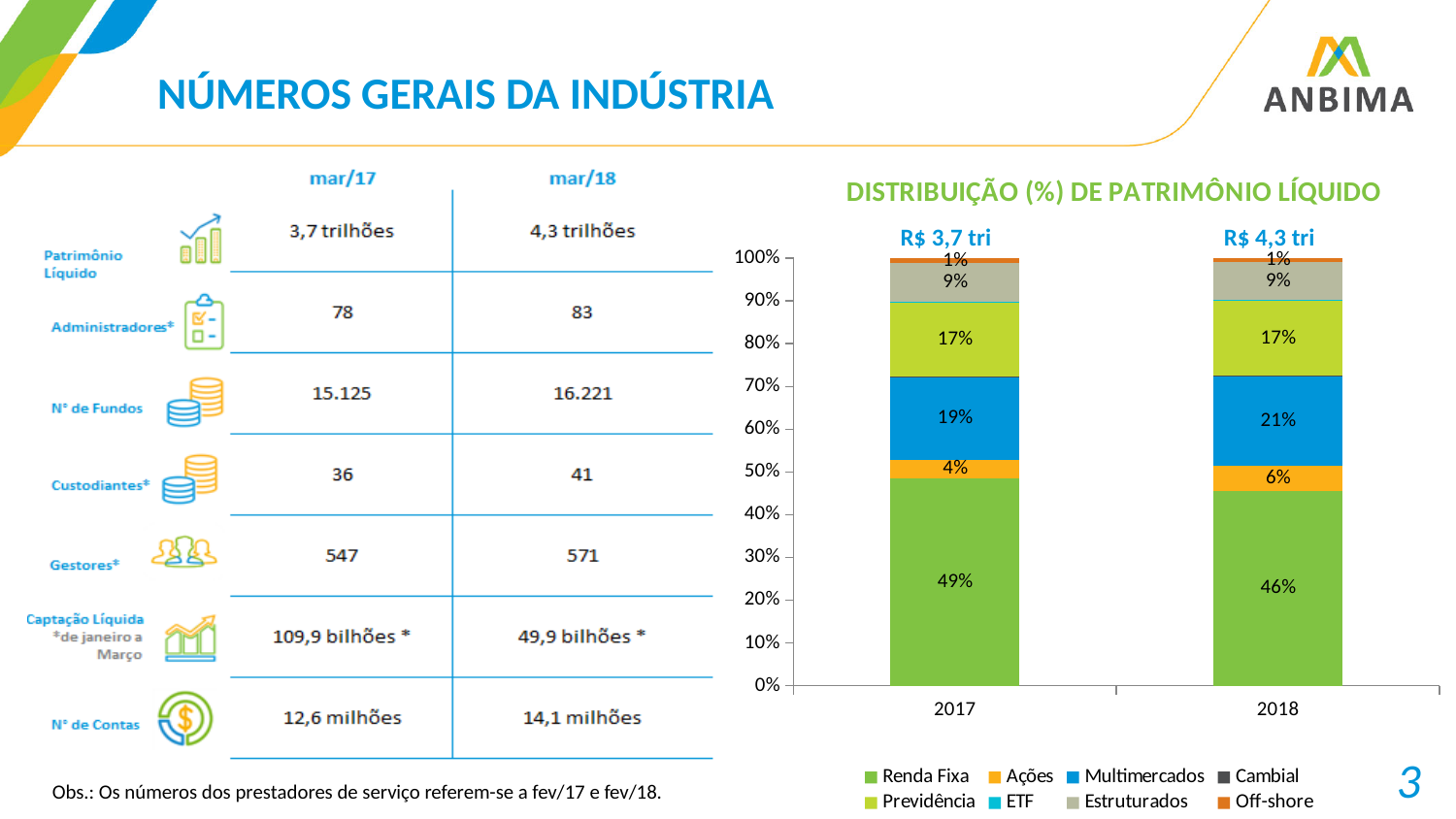
In the chart, is the Ações share larger in 2017 or in 2018? 2018 How many series does the chart's legend list? 8 In the chart, what is the Renda Fixa share for 2018? 46% In the chart, by how many percentage points did the Multimercados share change from 2017 to 2018? 2 percentage points What total value is printed above the 2018 bar in the chart? R$ 4,3 tri In the chart, which category has the largest share in 2018? Renda Fixa In the chart, what is the Previdência share for 2018? 17% In the chart, what is the Renda Fixa share for 2017? 49% What type of chart is shown under the title 'DISTRIBUIÇÃO (%) DE PATRIMÔNIO LÍQUIDO'? Stacked bar chart How many years (bars) are shown on the x axis of the chart? 2 In the chart, what is the Multimercados share for 2018? 21% In the chart, what is the Ações share for 2017? 4%